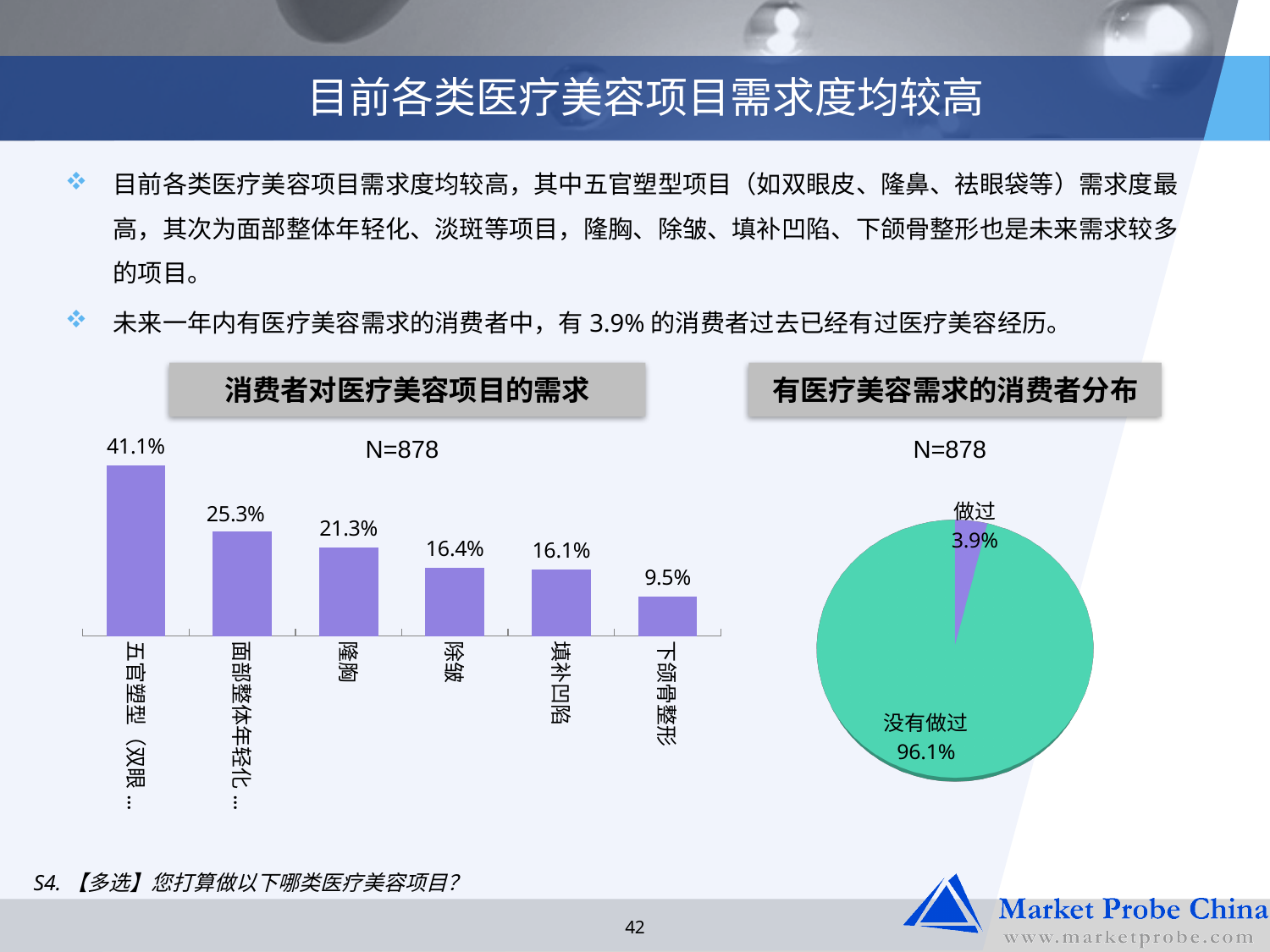
In the pie chart titled 有医疗美容需求的消费者分布, what share does 做过 have? 3.9% In the bar chart titled 消费者对医疗美容项目的需求, what is the value for 下颌骨整形? 9.5% What kind of chart is the left chart titled 消费者对医疗美容项目的需求? bar chart In the bar chart titled 消费者对医疗美容项目的需求, what is the difference between the values for 五官塑型 and 面部整体年轻化? 15.8% How many categories are shown in the bar chart titled 消费者对医疗美容项目的需求? 6 In the bar chart titled 消费者对医疗美容项目的需求, which category has the highest value? 五官塑型 In the pie chart titled 有医疗美容需求的消费者分布, what is the value for 没有做过? 96.1% In the bar chart titled 消费者对医疗美容项目的需求, do the values rise or fall from left to right? fall What sample size (N) is shown for the pie chart titled 有医疗美容需求的消费者分布? N=878 In the bar chart titled 消费者对医疗美容项目的需求, which is larger, the value for 隆胸 or the value for 除皱? 隆胸 In the bar chart titled 消费者对医疗美容项目的需求, which category has the lowest value? 下颌骨整形 In the bar chart titled 消费者对医疗美容项目的需求, what is the value for 隆胸? 21.3%